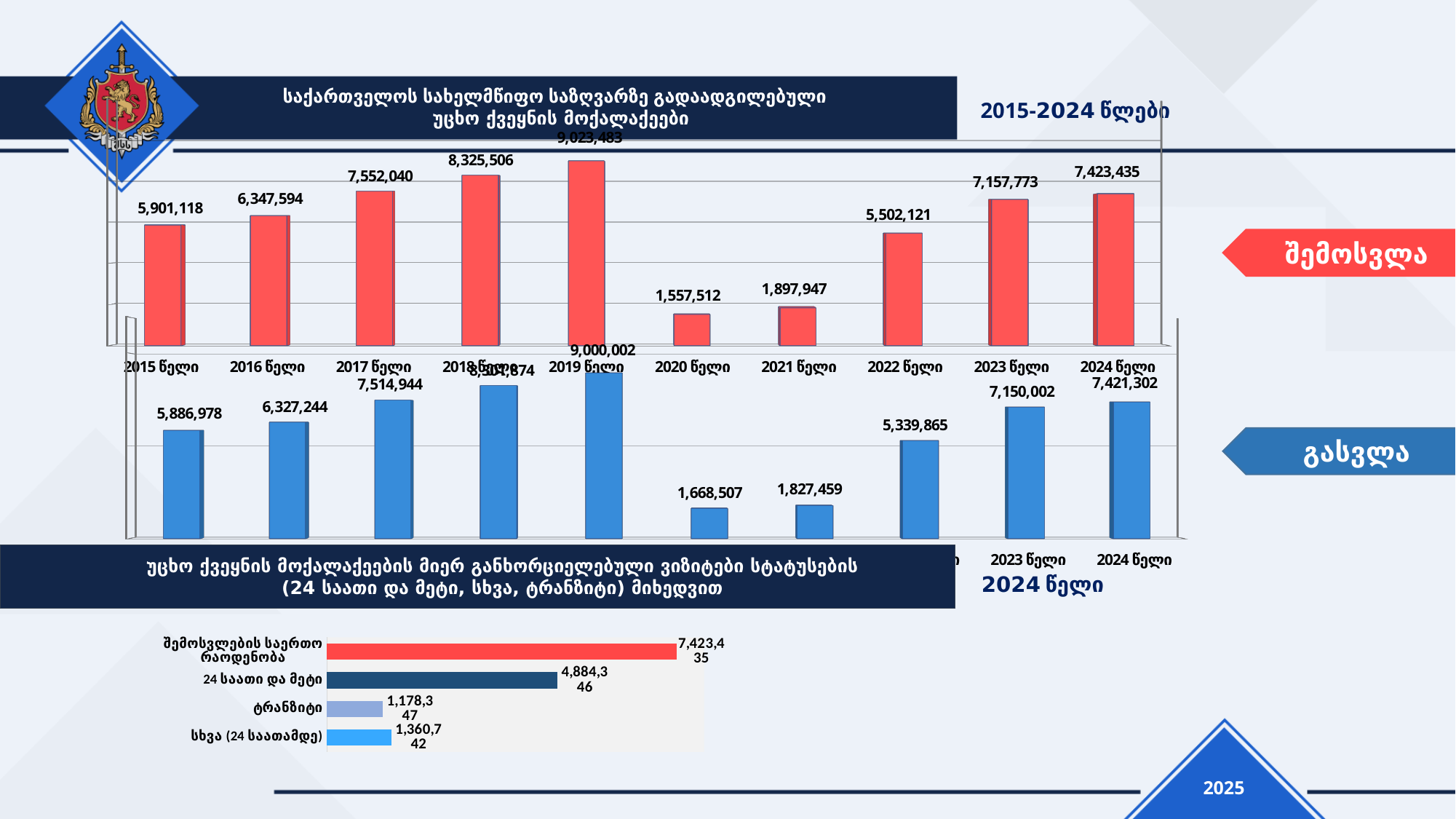
In the blue bar chart (გასვლა) in the middle, do the values rise or fall from 2015 წელი to 2019 წელი? rise In the horizontal bar chart at the bottom (2024 წელი), what is the value for ტრანზიტი? 1,178,347 In the red bar chart (შემოსვლა) at the top, what is the difference between the values for 2024 წელი and 2023 წელი? 265,662 In the red bar chart (შემოსვლა) at the top, how many years are shown? 10 What kind of chart is the chart at the bottom of the slide (2024 წელი)? bar chart In the red bar chart (შემოსვლა) at the top, what is the value for 2020 წელი? 1,557,512 In the red bar chart (შემოსვლა) at the top, which year has the lowest value? 2020 წელი In the blue bar chart (გასვლა) in the middle, is the value for 2021 წელი larger or smaller than the value for 2020 წელი? larger In the blue bar chart (გასვლა) in the middle, what is the value for 2022 წელი? 5,339,865 In the blue bar chart (გასვლა) in the middle, which year has the lowest value? 2020 წელი In the red bar chart (შემოსვლა) at the top, which year has the highest value? 2019 წელი In the red bar chart (შემოსვლა) at the top, what is the value for 2019 წელი? 9,023,483